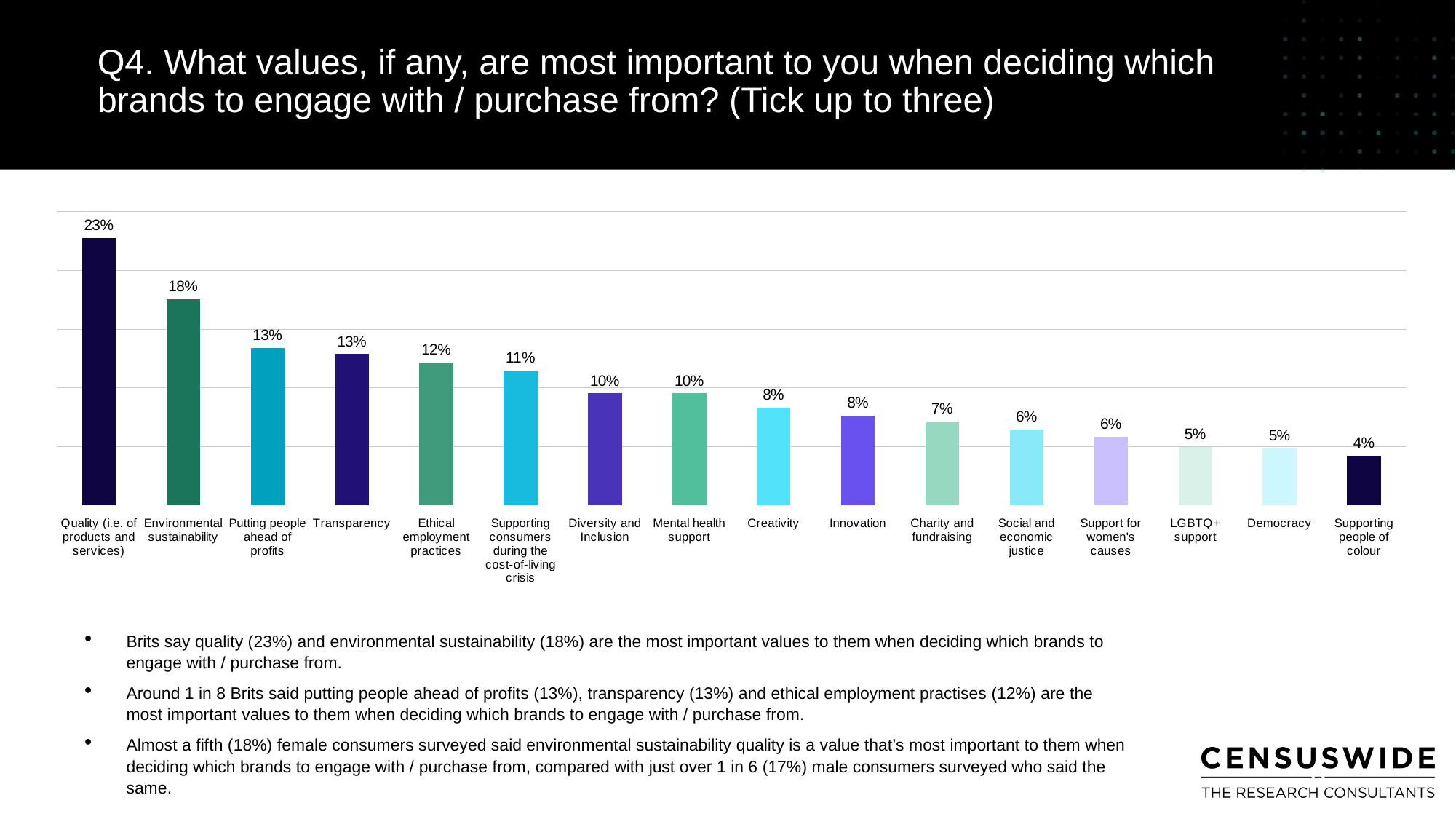
Which has a higher value, Creativity or Charity and fundraising? Creativity Which category has the highest value in the chart? Quality (i.e. of products and services) How many categories are shown in the chart? 16 Do the values rise or fall moving from left to right along the x axis? Fall What type of chart is shown on the slide? Bar chart What is the difference between the values for Quality (i.e. of products and services) and Environmental sustainability? 5% What is the value shown for Supporting consumers during the cost-of-living crisis? 11% What percentage of respondents chose Environmental sustainability as a most important value? 18% Which has a higher value, Diversity and Inclusion or Innovation? Diversity and Inclusion What is the difference between the values for Ethical employment practices and Democracy? 7% Which category has the lowest value in the chart? Supporting people of colour What is the value shown for Mental health support? 10%